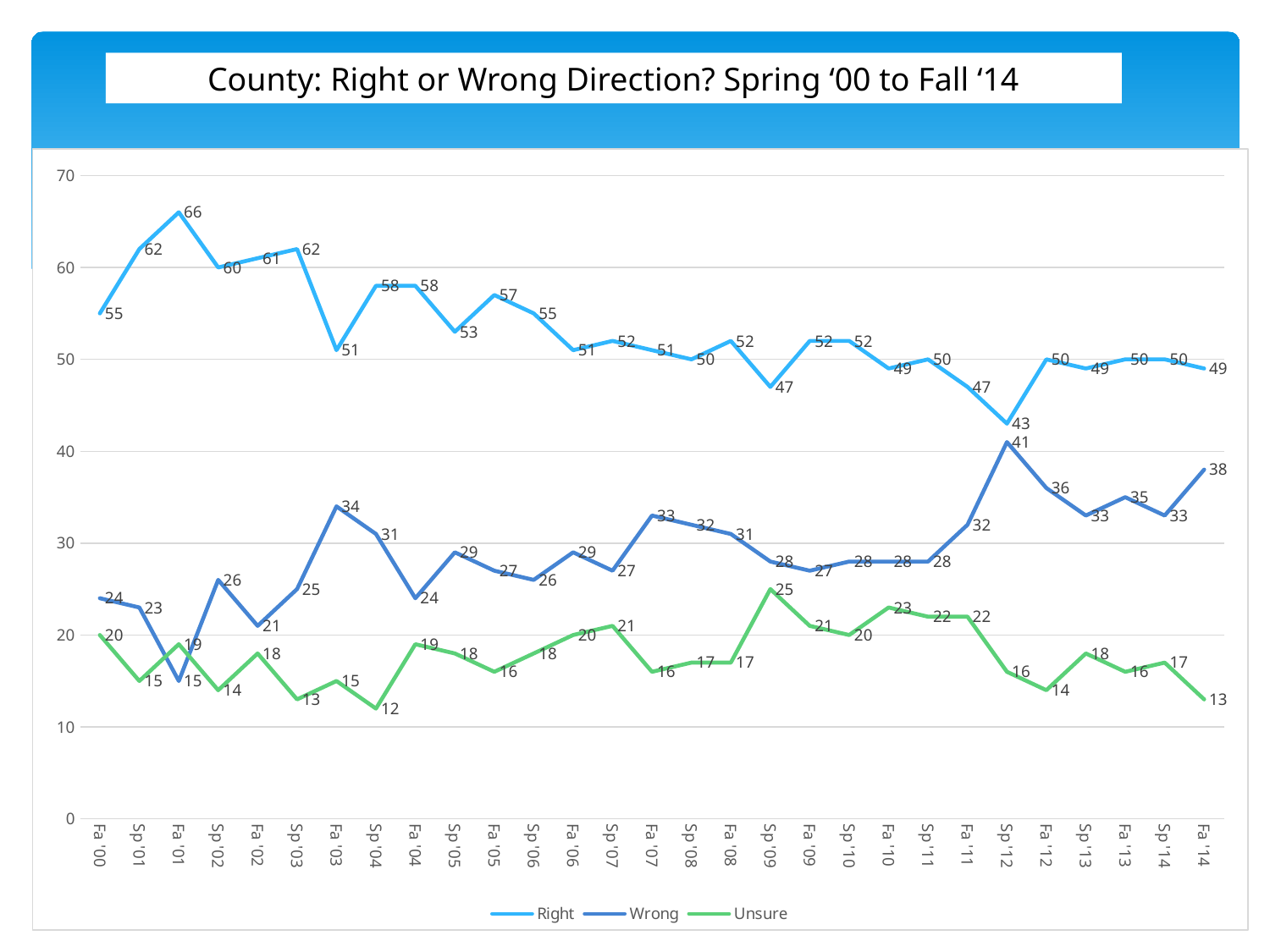
At which period is the Right series at its highest? Fa '01 At which period is the Unsure series at its lowest? Sp '04 How many series does the legend list? 3 What is the value for Right at Fa '01? 66 What is the difference between Right and Wrong at Fa '14? 11 What is the value for Wrong at Sp '12? 41 At which period is the Right series at its lowest? Sp '12 At which period is the Unsure series at its highest? Sp '09 At Fa '01, which is larger: Wrong or Unsure? Unsure Does the Wrong series rise or fall from Sp '11 to Sp '12? rise How many time periods are plotted along the x axis? 29 What kind of chart is shown on the slide? line chart